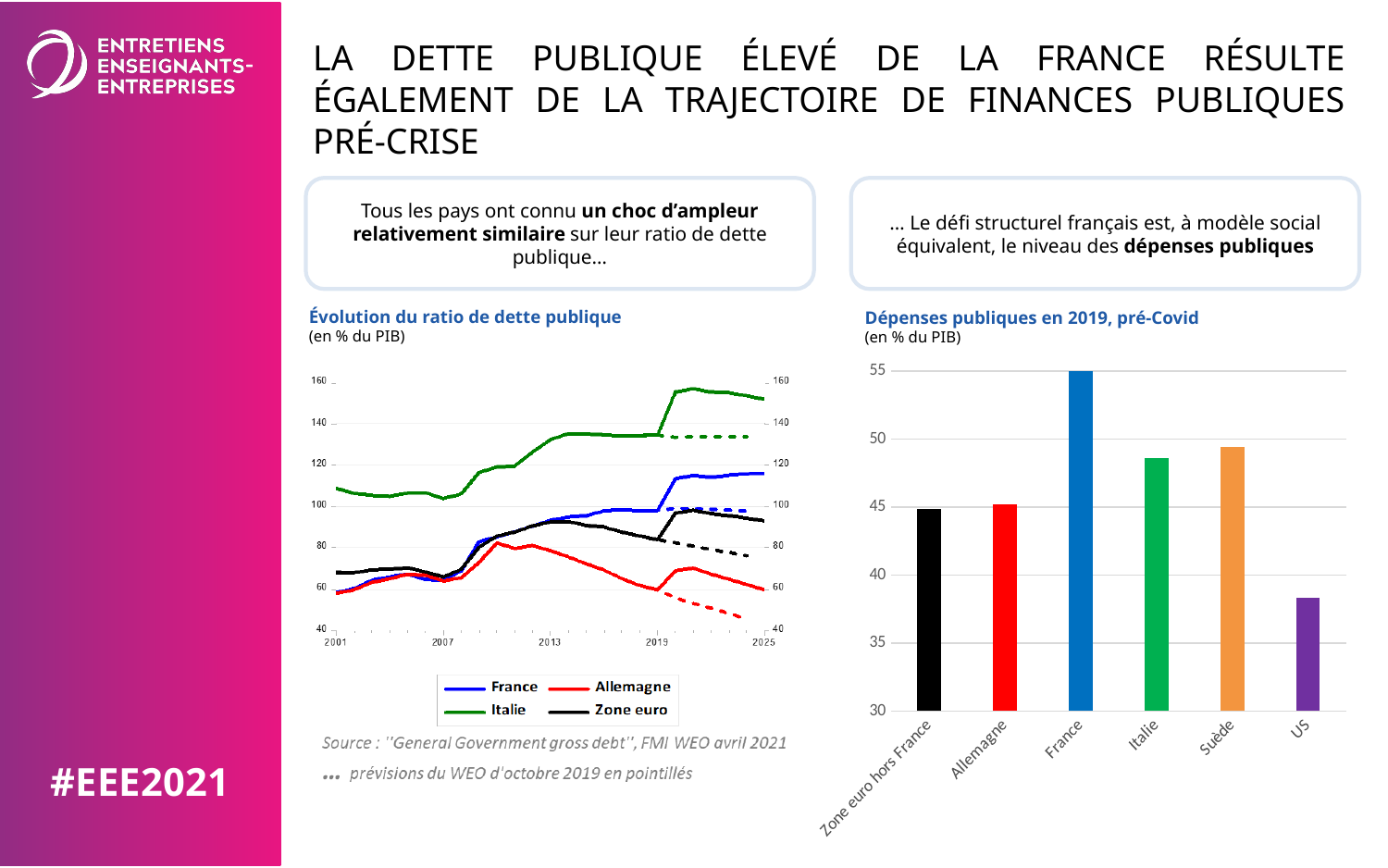
In the 'Évolution du ratio de dette publique' chart, does the Italie series rise or fall between 2001 and 2025? rise In the 'Dépenses publiques en 2019, pré-Covid' chart, which is larger, the value for France or the value for Allemagne? France In the 'Dépenses publiques en 2019, pré-Covid' chart, which category has the highest value? France What kind of chart is the 'Dépenses publiques en 2019, pré-Covid' chart on the right? bar chart In the 'Évolution du ratio de dette publique' chart, which series has the highest value in 2025? Italie What kind of chart is the 'Évolution du ratio de dette publique' chart on the left? line chart How many series does the legend of the 'Évolution du ratio de dette publique' chart list? 4 In the 'Dépenses publiques en 2019, pré-Covid' chart, which category has the lowest value? US In the 'Évolution du ratio de dette publique' chart, which series has the lowest value in 2025? Allemagne In the 'Dépenses publiques en 2019, pré-Covid' chart, is the value for US greater or less than 40? less In the 'Évolution du ratio de dette publique' chart, is the value for Italie in 2025 greater or less than 140? greater How many categories are shown in the 'Dépenses publiques en 2019, pré-Covid' chart? 6